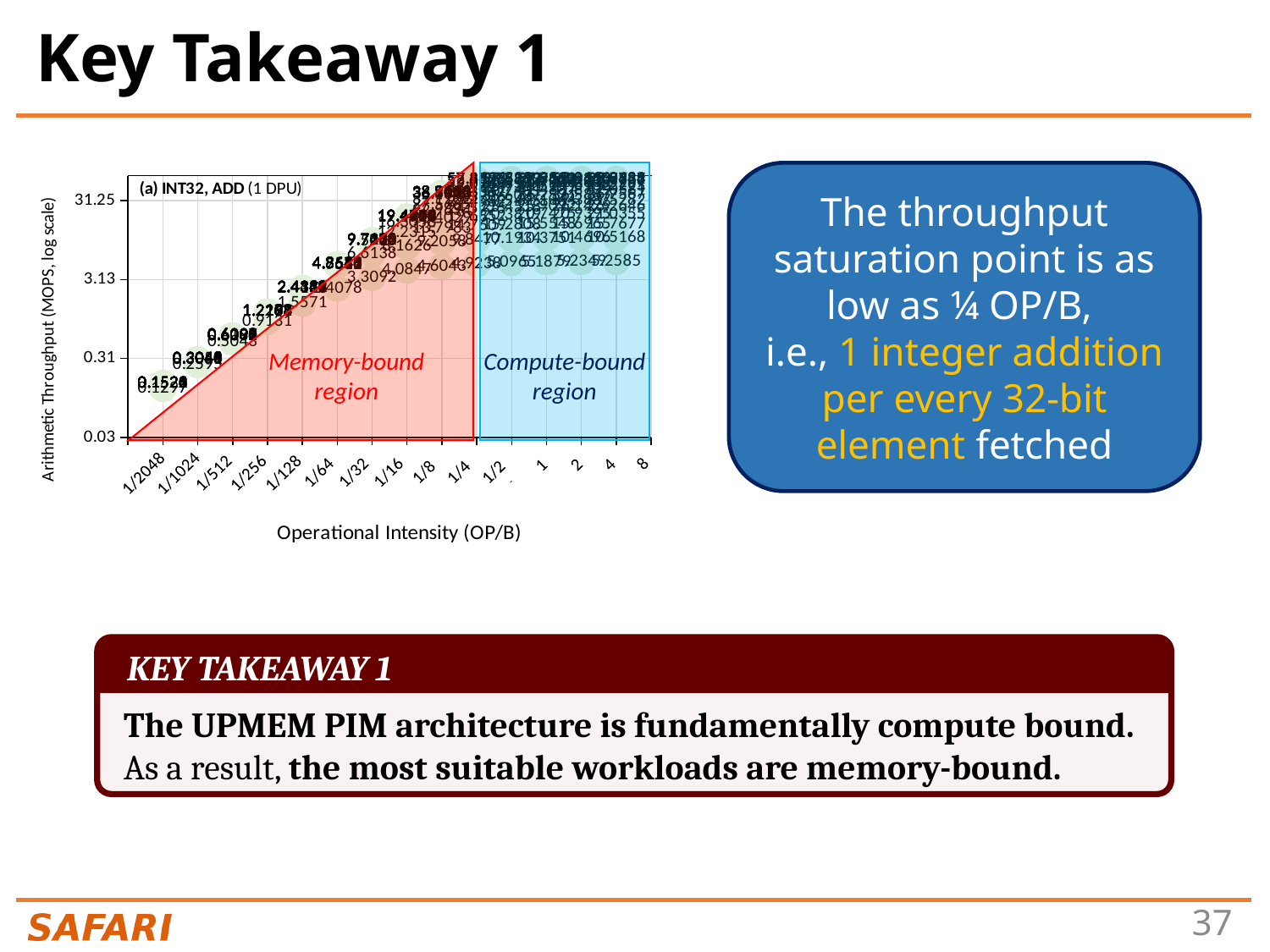
What kind of chart is shown on the slide? scatter chart Is the arithmetic throughput at operational intensity 8 greater or less than 3.13 MOPS? greater What is the label of the x axis of the chart? Operational Intensity (OP/B) At which operational intensity is the arithmetic throughput lowest? 1/2048 Is the arithmetic throughput at operational intensity 1/4 greater or less than 3.13 MOPS? greater Does arithmetic throughput rise or fall as operational intensity increases from 1/2048 to 1/4? rises Which has the higher arithmetic throughput: operational intensity 1/2048 or 1/4? 1/4 How many operational intensity values are marked on the x axis of the chart? 15 Which has the higher arithmetic throughput: operational intensity 1/512 or 1/32? 1/32 What are the names of the two shaded regions in the chart? Memory-bound region and Compute-bound region Is the arithmetic throughput at operational intensity 1/2048 greater or less than 0.31 MOPS? less